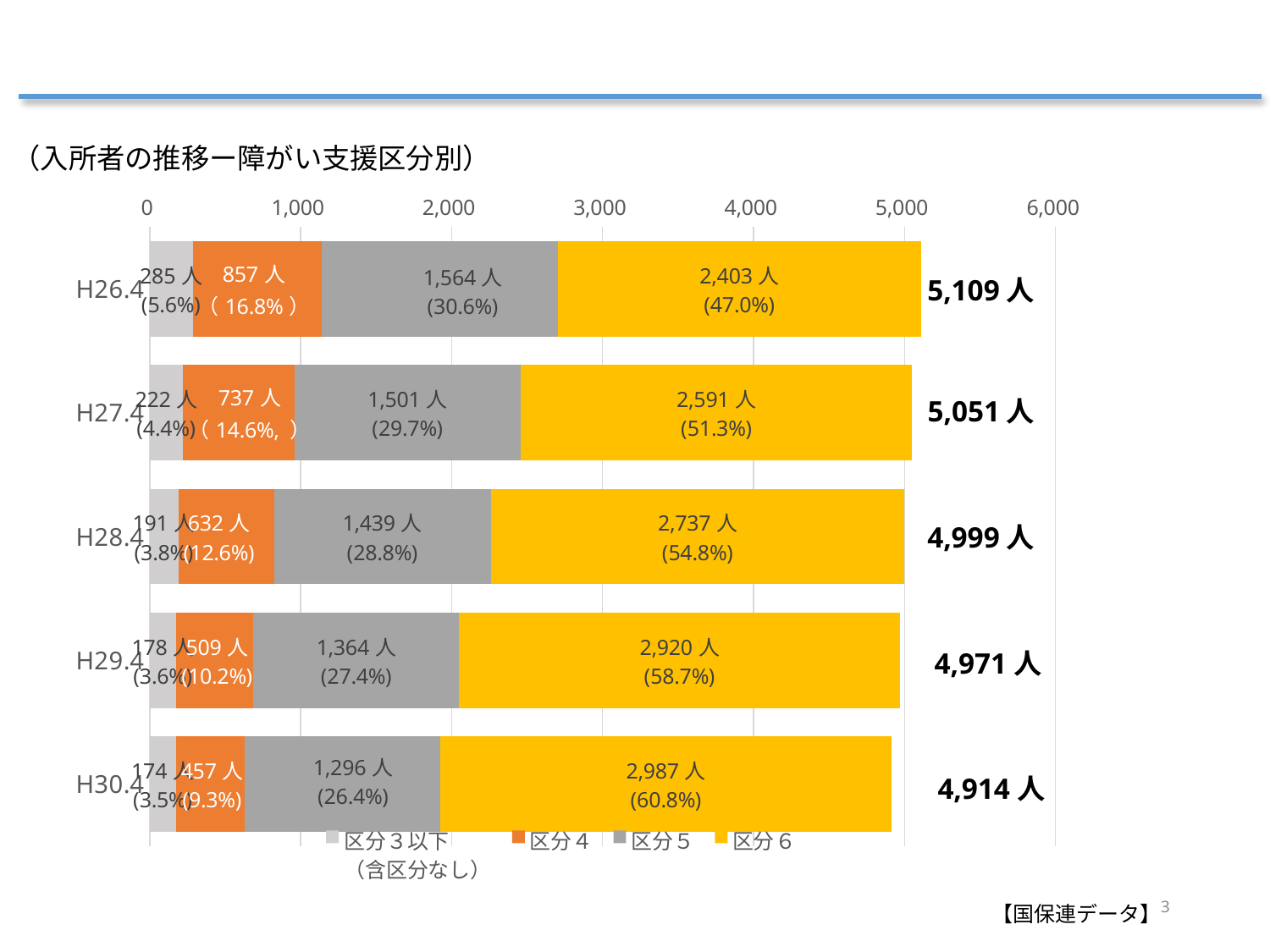
How does the total number of residents change from H26.4 to H30.4? It decreases What is the value for 区分4 in H26.4? 857 人 What kind of chart is shown on the slide? Stacked bar chart What is the difference between the 区分6 values for H30.4 and H26.4? 584 人 What percentage share does 区分5 have in H28.4? 28.8% What is the value for 区分6 in H30.4? 2,987 人 Which period has the lowest value for 区分3以下（含区分なし）? H30.4 What is the total number of residents shown for H27.4? 5,051 人 Which is larger: the 区分5 value in H29.4 or the 区分5 value in H30.4? H29.4 How many time periods (categories) are plotted on the chart? 5 How many series does the legend list? 4 Which period has the highest total number of residents? H26.4